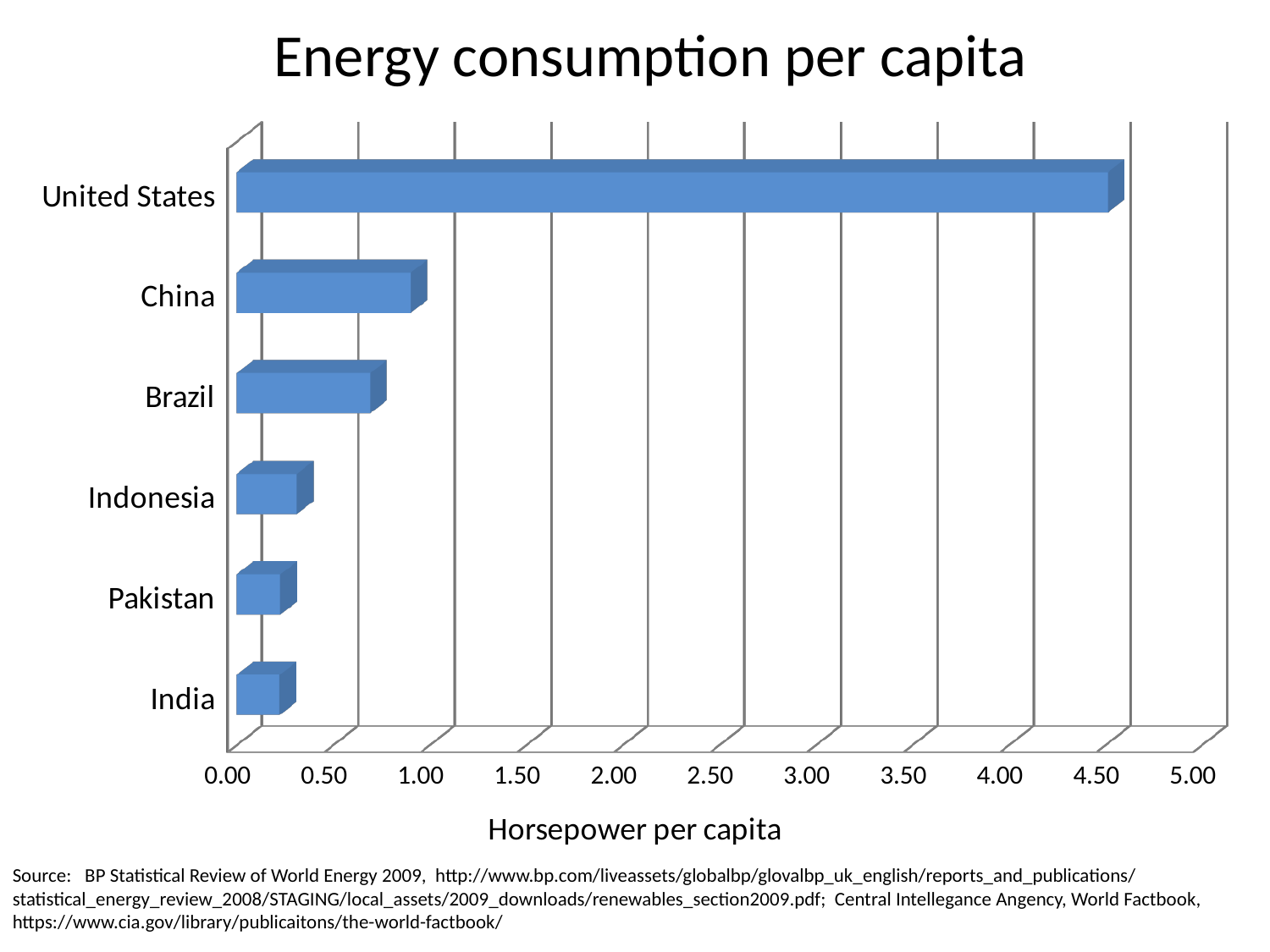
What is the label on the horizontal axis? Horsepower per capita How many countries are shown in the chart? 6 Is the value for Brazil greater or less than 1.00? less Which country has the highest energy consumption per capita? United States Is the value for China greater or less than 0.50? greater Which has a higher energy consumption per capita, China or Brazil? China Is the value for India greater or less than 0.50? less What kind of chart is shown on the slide? bar chart Which has a higher energy consumption per capita, Indonesia or Brazil? Brazil What is the title of the chart? Energy consumption per capita